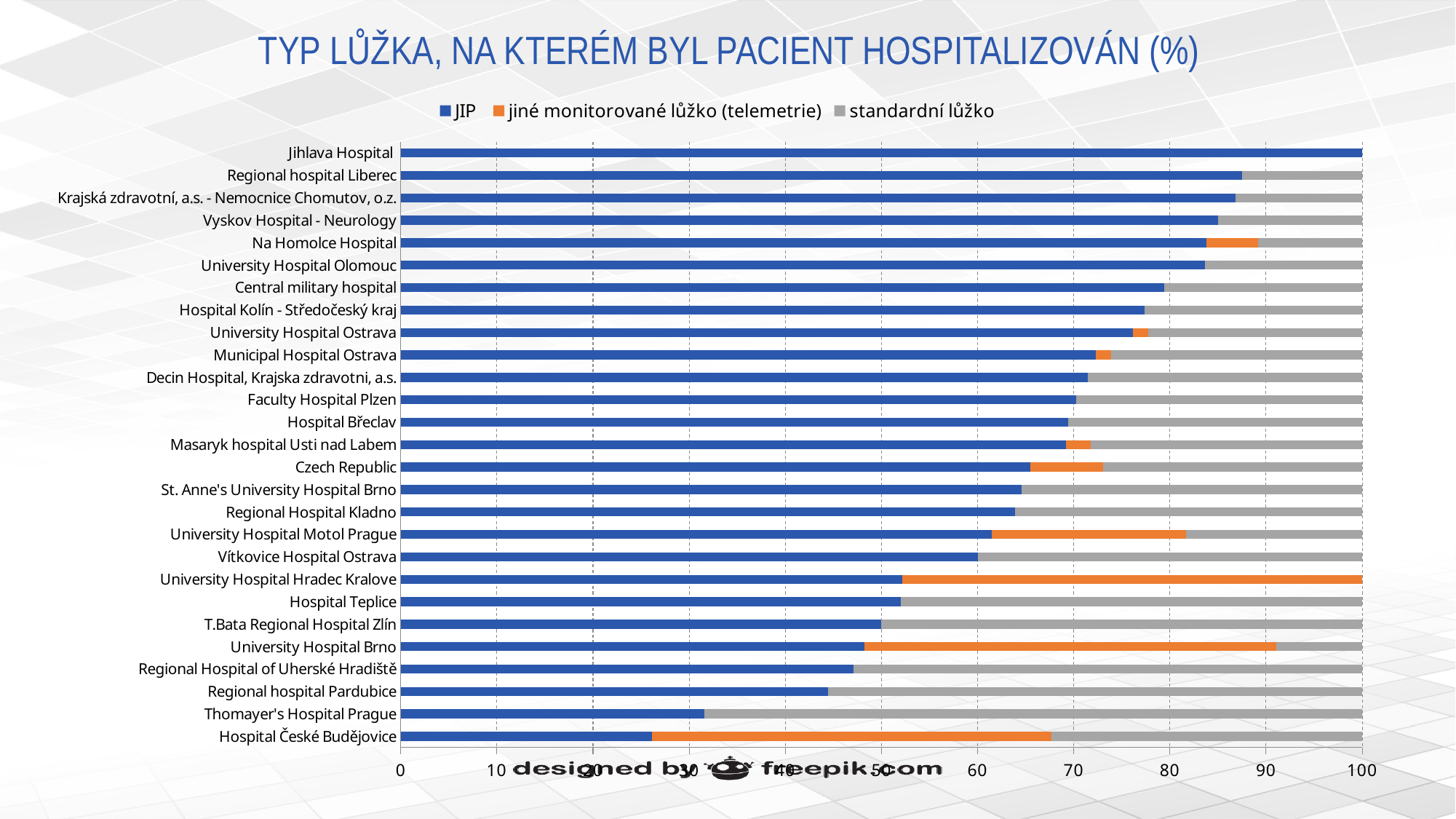
Is the JIP value for Regional Hospital Kladno greater or less than 60? greater Which has a larger JIP share, Thomayer's Hospital Prague or Regional hospital Liberec? Regional hospital Liberec How many hospitals (categories) are plotted on the chart? 27 Is the JIP value for Regional hospital Pardubice greater or less than 50? less What kind of chart is shown on the slide? Stacked bar chart Is the JIP value for Hospital České Budějovice greater or less than 30? less What is the JIP value for Jihlava Hospital? 100 Which colour represents the JIP series in the legend? Blue Which hospital has the largest 'jiné monitorované lůžko (telemetrie)' segment? University Hospital Hradec Kralove Which hospital has the highest JIP share? Jihlava Hospital How many series does the legend list? 3 Which hospital has the lowest JIP share? Hospital České Budějovice